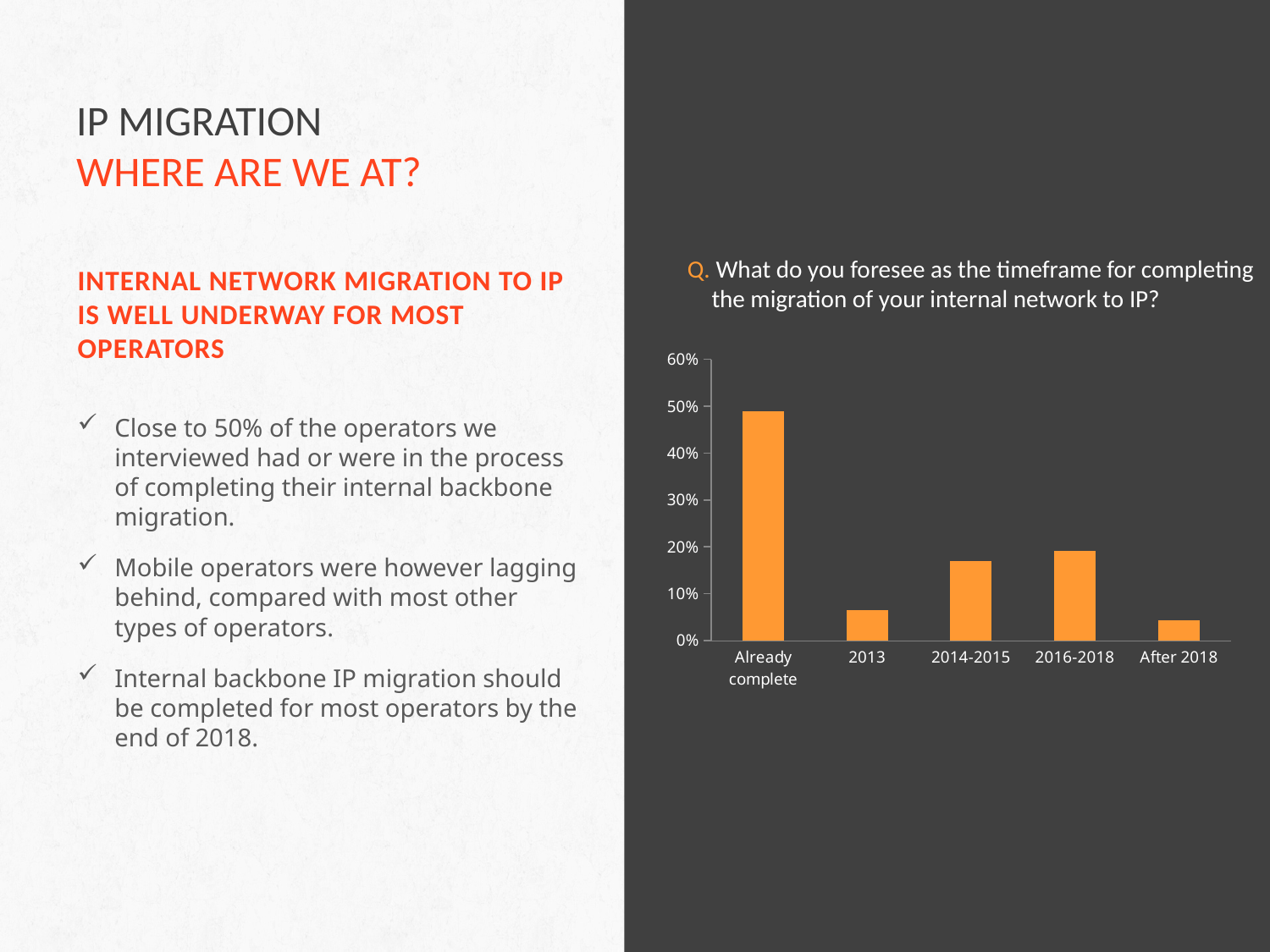
Is the value for 2013 greater or less than 10%? less Which category has the highest bar in the chart? Already complete Which is larger, the value for 2014-2015 or the value for 2013? 2014-2015 What kind of chart is shown on the slide? bar chart Is the value for 2014-2015 greater or less than 10%? greater How many categories are shown on the x axis of the chart? 5 Which category has the lowest bar in the chart? After 2018 Which is larger, the value for 2016-2018 or the value for After 2018? 2016-2018 Is the value for Already complete greater or less than 40%? greater What is the highest value shown on the chart's y axis? 60%